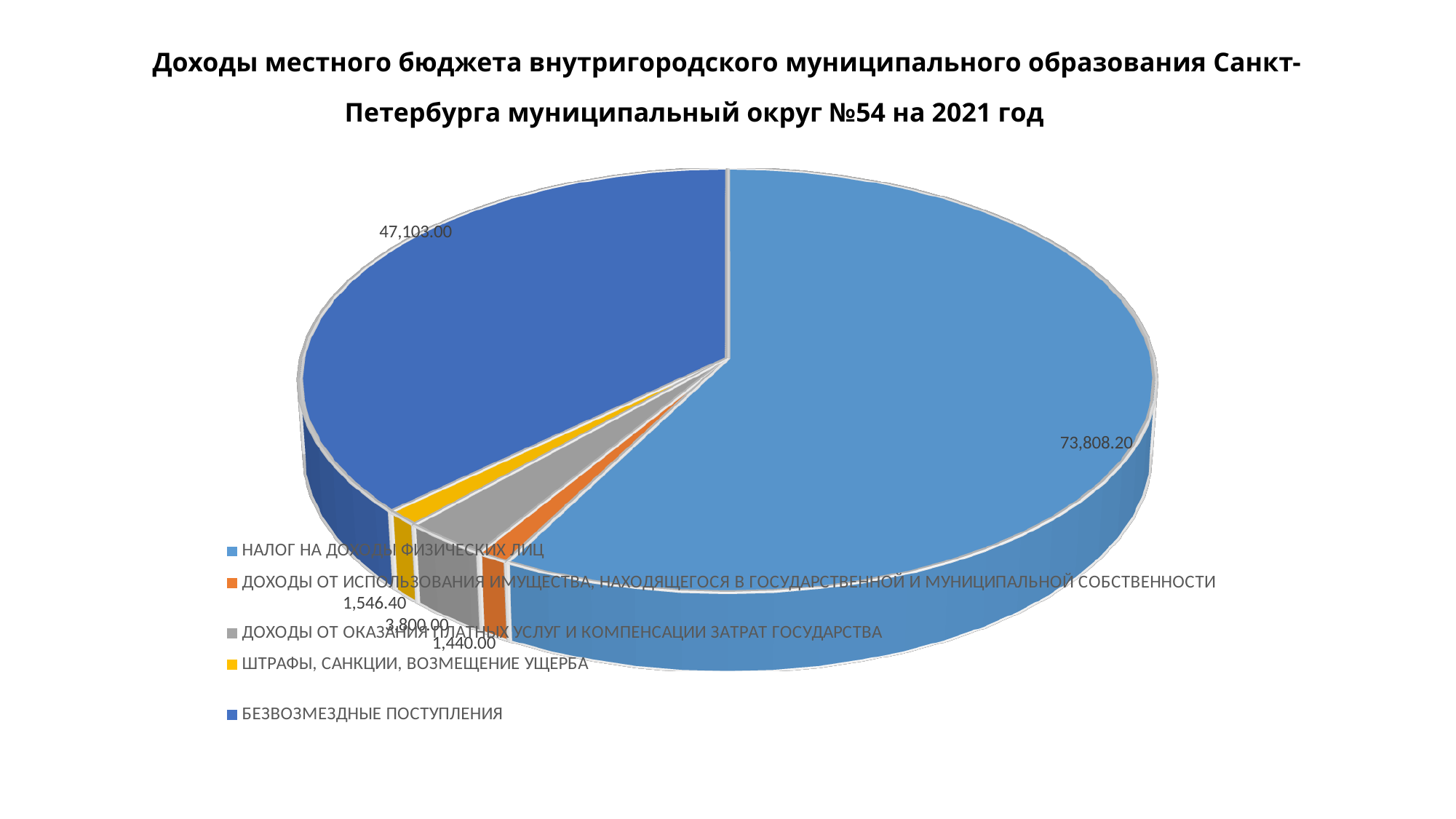
What year does the chart title refer to? 2021 What is the value for НАЛОГ НА ДОХОДЫ ФИЗИЧЕСКИХ ЛИЦ? 73,808.20 What is the value for ДОХОДЫ ОТ ОКАЗАНИЯ ПЛАТНЫХ УСЛУГ И КОМПЕНСАЦИИ ЗАТРАТ ГОСУДАРСТВА? 3,800.00 What colour is the slice for БЕЗВОЗМЕЗДНЫЕ ПОСТУПЛЕНИЯ? dark blue How many slices does the pie chart have? 5 Which category has the largest slice of the pie? НАЛОГ НА ДОХОДЫ ФИЗИЧЕСКИХ ЛИЦ What is the difference between the values for НАЛОГ НА ДОХОДЫ ФИЗИЧЕСКИХ ЛИЦ and БЕЗВОЗМЕЗДНЫЕ ПОСТУПЛЕНИЯ? 26,705.20 Which is larger, ДОХОДЫ ОТ ОКАЗАНИЯ ПЛАТНЫХ УСЛУГ И КОМПЕНСАЦИИ ЗАТРАТ ГОСУДАРСТВА or ДОХОДЫ ОТ ИСПОЛЬЗОВАНИЯ ИМУЩЕСТВА, НАХОДЯЩЕГОСЯ В ГОСУДАРСТВЕННОЙ И МУНИЦИПАЛЬНОЙ СОБСТВЕННОСТИ? ДОХОДЫ ОТ ОКАЗАНИЯ ПЛАТНЫХ УСЛУГ И КОМПЕНСАЦИИ ЗАТРАТ ГОСУДАРСТВА What is the value for БЕЗВОЗМЕЗДНЫЕ ПОСТУПЛЕНИЯ? 47,103.00 What kind of chart is shown on the slide? pie chart How many entries does the legend list? 5 Which is larger, НАЛОГ НА ДОХОДЫ ФИЗИЧЕСКИХ ЛИЦ or БЕЗВОЗМЕЗДНЫЕ ПОСТУПЛЕНИЯ? НАЛОГ НА ДОХОДЫ ФИЗИЧЕСКИХ ЛИЦ